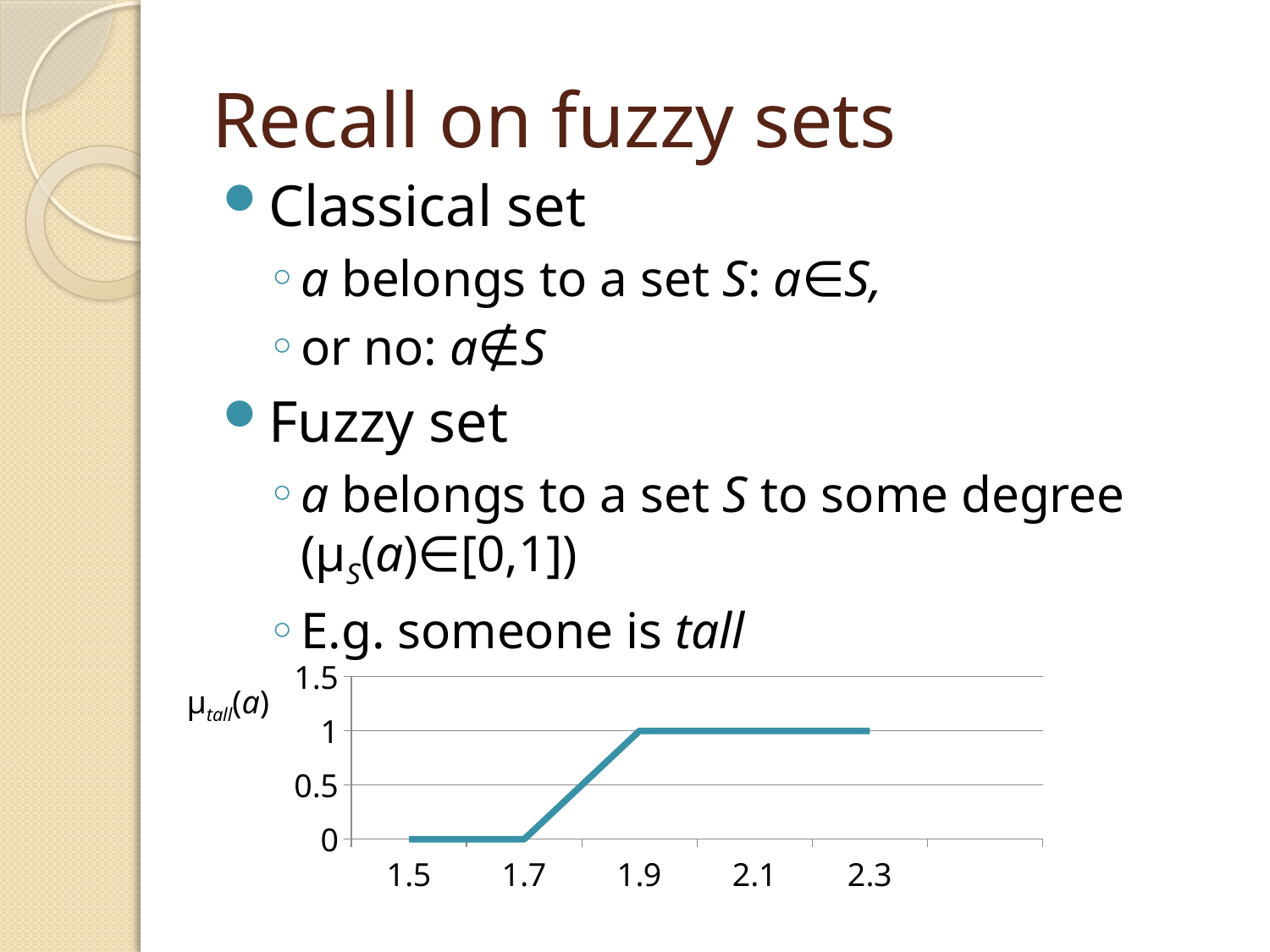
What is the value of μ_tall(a) at a = 2.3? 1 What is the value of μ_tall(a) at a = 1.5? 0 What is the difference between the value at a = 1.9 and the value at a = 1.7? 1 Which has the larger value of μ_tall(a): a = 1.5 or a = 2.1? 2.1 What is the value of μ_tall(a) at a = 1.9? 1 Does the plotted line rise or fall between a = 1.7 and a = 1.9? rise What kind of chart is shown on the slide? line chart How many labelled tick values are shown on the x axis? 5 What is the highest value the plotted line reaches? 1 What is the label on the vertical axis of the chart? μ_tall(a) Is the value of μ_tall(a) at a = 2.0 greater or less than 0.5? greater What is the value of μ_tall(a) at a = 1.7? 0